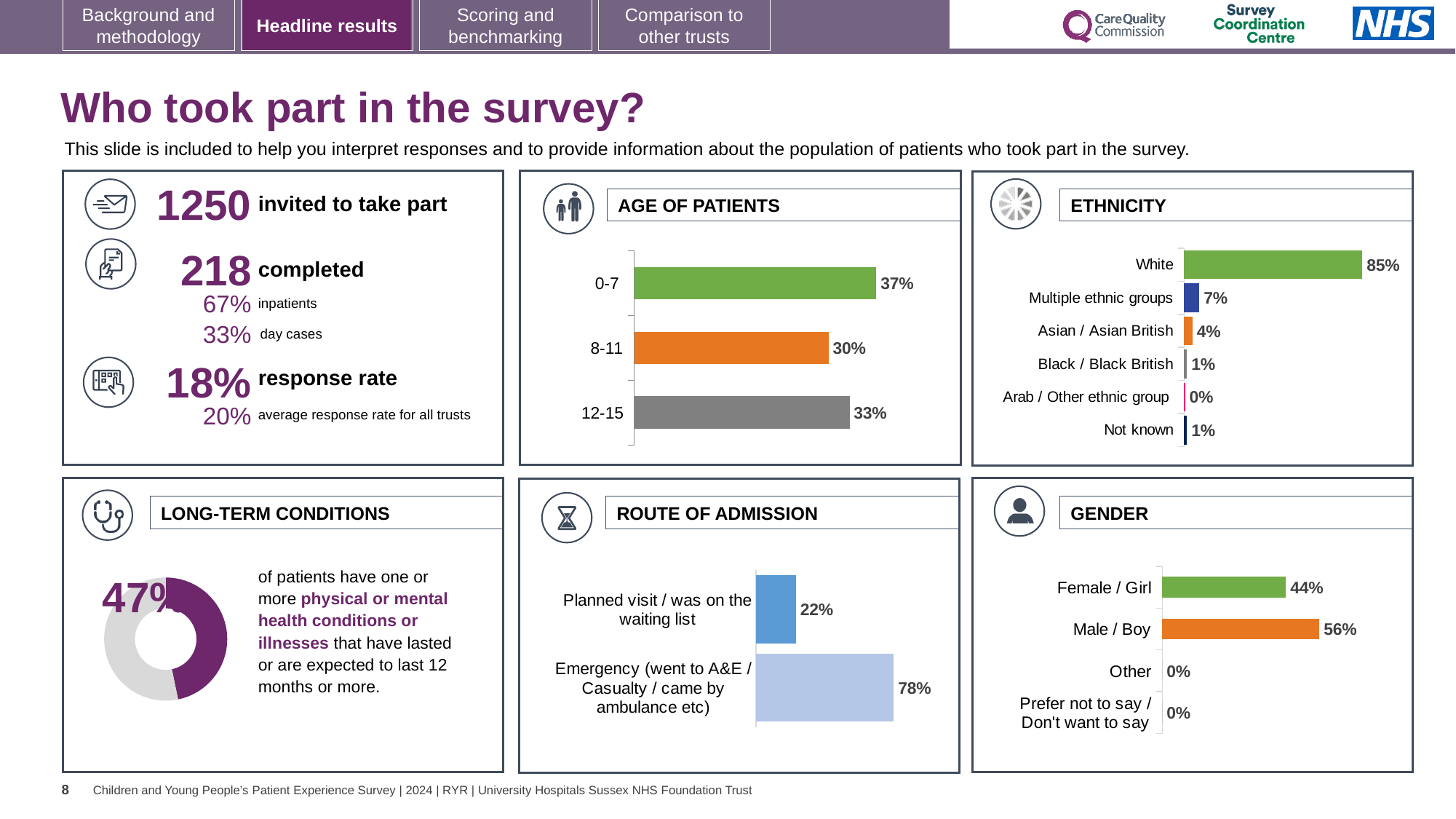
How many categories does the ETHNICITY chart show? 6 What kind of chart is used in the LONG-TERM CONDITIONS panel? Doughnut chart In the ETHNICITY chart, what is the value for Multiple ethnic groups? 7% In the GENDER chart, what is the value for Male / Boy? 56% In the AGE OF PATIENTS chart, which age group has the highest value? 0-7 In the GENDER chart, which is larger: Female / Girl or Male / Boy? Male / Boy In the AGE OF PATIENTS chart, what is the value for the 8-11 age group? 30% In the ROUTE OF ADMISSION chart, what is the difference between the Emergency and Planned visit values? 56% In the AGE OF PATIENTS chart, what is the difference between the 0-7 and 12-15 values? 4% In the ETHNICITY chart, which category has the highest value? White In the ETHNICITY chart, which is larger: Asian / Asian British or Black / Black British? Asian / Asian British In the ROUTE OF ADMISSION chart, what is the value for Emergency (went to A&E / Casualty / came by ambulance etc)? 78%